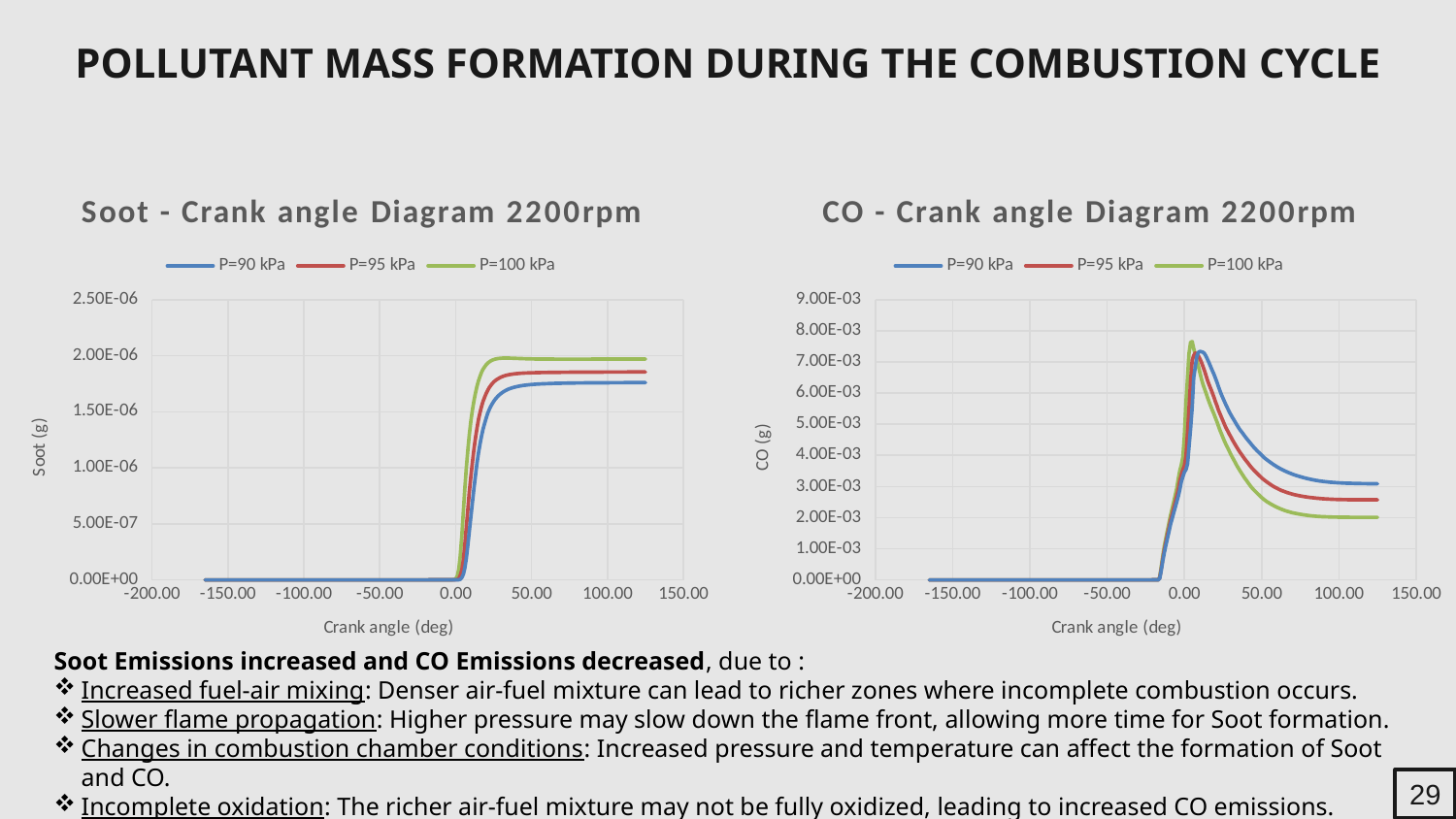
In the 'CO - Crank angle Diagram 2200rpm' chart, at a crank angle of 100.00, which is larger: the CO value for P=90 kPa or for P=100 kPa? P=90 kPa What is the x-axis title of the 'CO - Crank angle Diagram 2200rpm' chart? Crank angle (deg) In the 'Soot - Crank angle Diagram 2200rpm' chart, which series has the lowest soot value at a crank angle of 100.00? P=90 kPa In the 'Soot - Crank angle Diagram 2200rpm' chart, is the soot value for P=100 kPa at a crank angle of 100.00 greater or less than 1.50E-06? greater What kind of chart is the 'Soot - Crank angle Diagram 2200rpm'? line chart How many series does the legend of the 'CO - Crank angle Diagram 2200rpm' chart list? 3 In the 'CO - Crank angle Diagram 2200rpm' chart, is the CO value for P=100 kPa at a crank angle of 100.00 greater or less than 3.00E-03? less In the 'Soot - Crank angle Diagram 2200rpm' chart, is the soot value for P=90 kPa at a crank angle of 100.00 greater or less than 2.00E-06? less In the 'Soot - Crank angle Diagram 2200rpm' chart, which series has the highest soot value at a crank angle of 100.00? P=100 kPa In the 'CO - Crank angle Diagram 2200rpm' chart, which series has the highest CO value at a crank angle of 100.00? P=90 kPa In the 'Soot - Crank angle Diagram 2200rpm' chart, do the soot values rise or fall between a crank angle of 0.00 and 50.00? rise In the 'CO - Crank angle Diagram 2200rpm' chart, do the CO values rise or fall between a crank angle of 50.00 and 100.00? fall